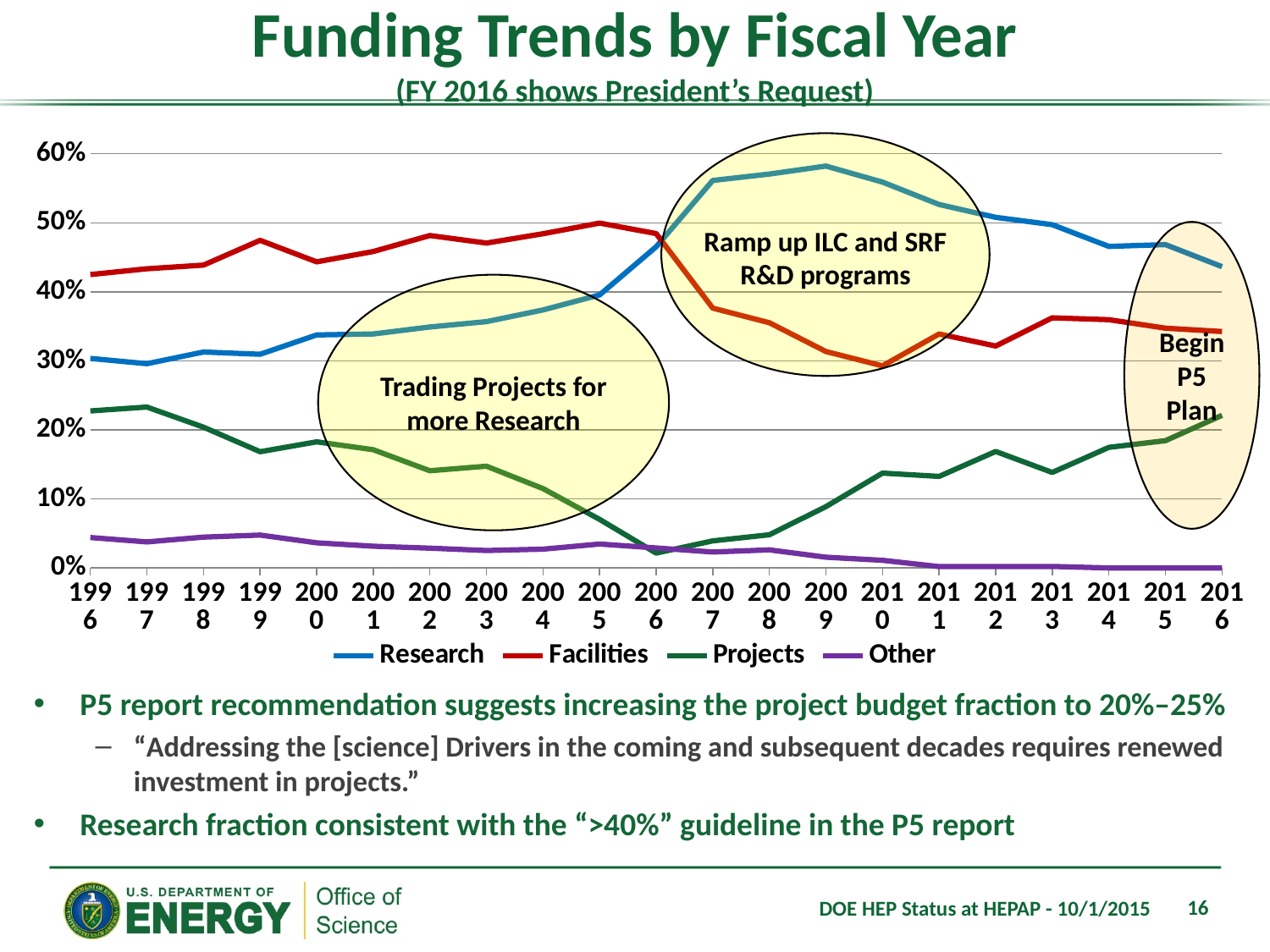
Does the Other series rise or fall from 1996 to 2016? Fall How many series does the legend list? 4 How many fiscal years are plotted along the x axis? 21 Which series has the lowest value in 2016? Other What kind of chart is shown on the slide? Line chart Is the value for Research in 1996 greater or less than 40%? less Which series has the highest value in 2009? Research In which fiscal year does the Projects series reach its lowest value? 2006 What is the title of the chart? Funding Trends by Fiscal Year Is the value for Research in 2009 greater or less than 50%? greater Is the value for Projects in 2006 greater or less than 10%? less In 1996, which is larger, the Facilities value or the Research value? Facilities